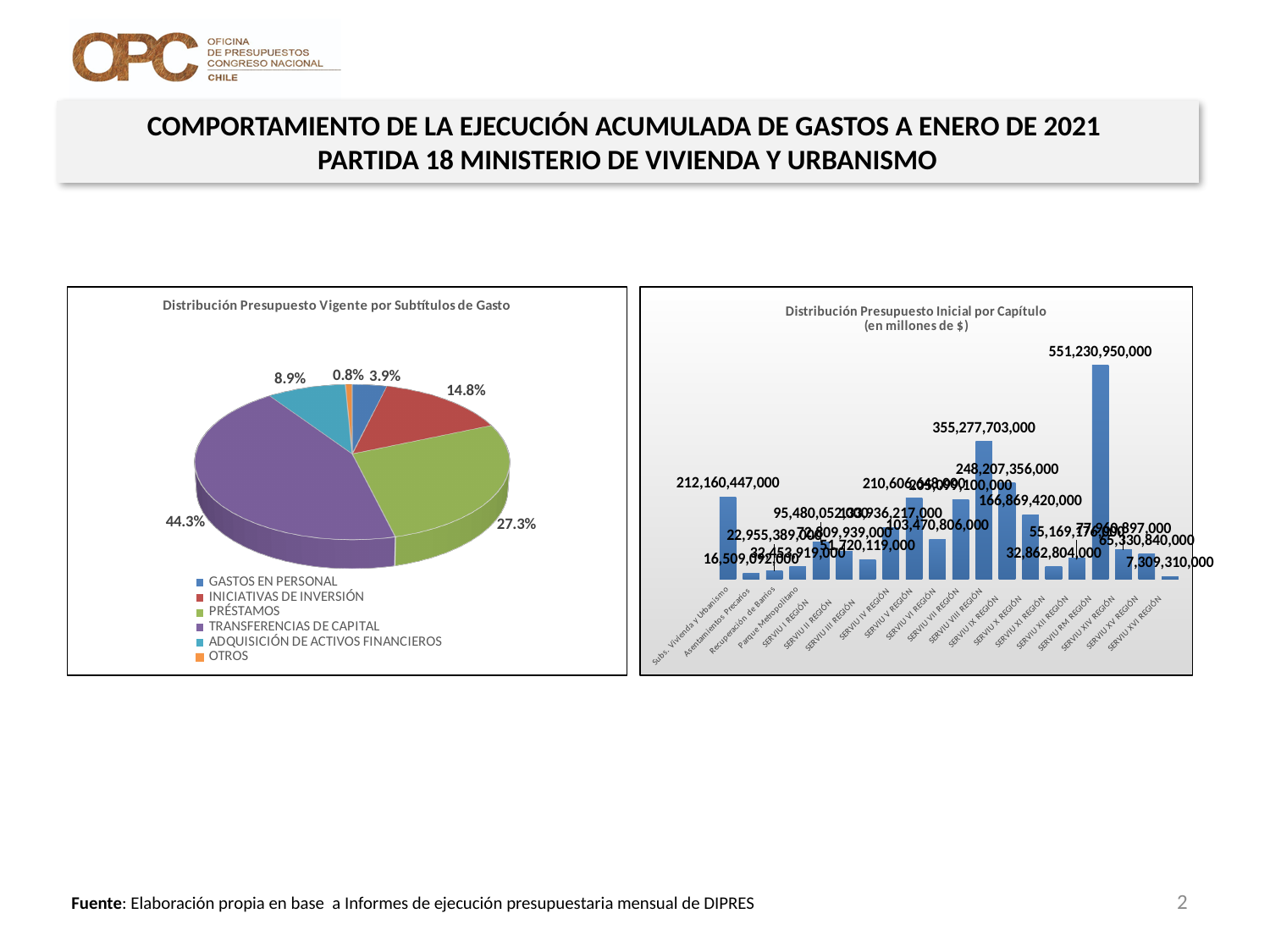
In the pie chart 'Distribución Presupuesto Vigente por Subtítulos de Gasto', what share does TRANSFERENCIAS DE CAPITAL have? 44.3% In the bar chart 'Distribución Presupuesto Inicial por Capítulo', what is the difference between SERVIU RM REGIÓN and SERVIU VIII REGIÓN? 195,953,247,000 In the bar chart 'Distribución Presupuesto Inicial por Capítulo', which capítulo has the highest value? SERVIU RM REGIÓN In the pie chart 'Distribución Presupuesto Vigente por Subtítulos de Gasto', by how many percentage points does TRANSFERENCIAS DE CAPITAL exceed PRÉSTAMOS? 17.0 percentage points In the pie chart 'Distribución Presupuesto Vigente por Subtítulos de Gasto', which is larger: INICIATIVAS DE INVERSIÓN or ADQUISICIÓN DE ACTIVOS FINANCIEROS? INICIATIVAS DE INVERSIÓN In the bar chart 'Distribución Presupuesto Inicial por Capítulo', what is the value for SERVIU VIII REGIÓN? 355,277,703,000 In the pie chart 'Distribución Presupuesto Vigente por Subtítulos de Gasto', what share does PRÉSTAMOS have? 27.3% In the bar chart 'Distribución Presupuesto Inicial por Capítulo', which capítulo has the lowest value? SERVIU XVI REGIÓN In the pie chart 'Distribución Presupuesto Vigente por Subtítulos de Gasto', how many categories does the legend list? 6 In the pie chart 'Distribución Presupuesto Vigente por Subtítulos de Gasto', which category has the smallest share? OTROS In the bar chart 'Distribución Presupuesto Inicial por Capítulo', what is the value for Asentamientos Precarios? 16,509,092,000 What kind of chart is 'Distribución Presupuesto Inicial por Capítulo'? Bar chart